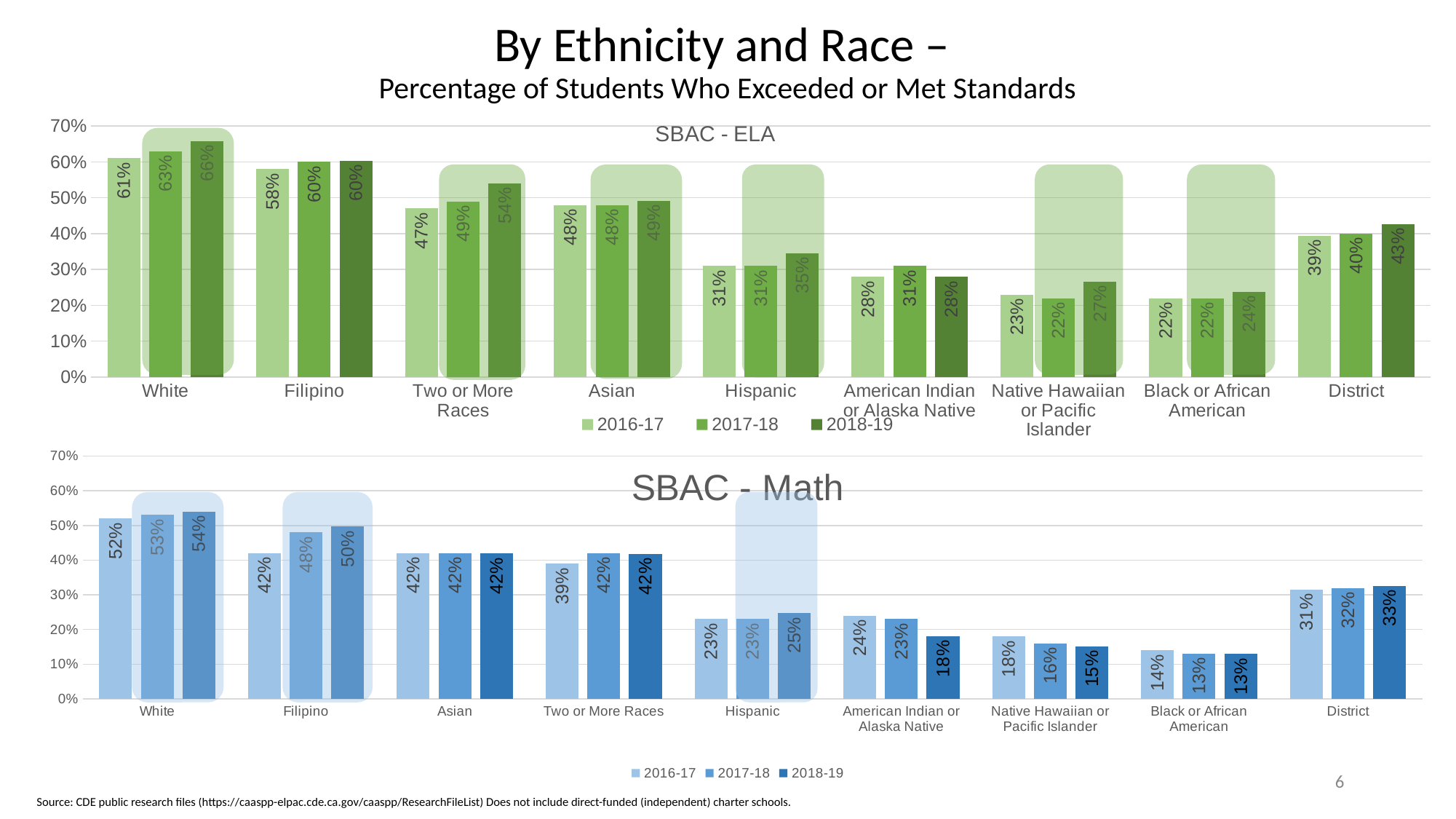
In the SBAC - Math chart, what is the difference between the 2016-17 and 2018-19 values for American Indian or Alaska Native? 6% In the SBAC - Math chart, which category has the highest value in 2018-19? White In the SBAC - ELA chart, do the values for Hispanic rise or fall from 2017-18 to 2018-19? rise In the SBAC - ELA chart, what is the District value for 2017-18? 40% In the SBAC - ELA chart, how many series does the legend list? 3 In the SBAC - ELA chart, what is the value for White in 2018-19? 66% In the SBAC - ELA chart, what is the difference between the 2018-19 and 2016-17 values for Two or More Races? 7% How many categories are shown on the x axis of the SBAC - Math chart? 9 In the SBAC - ELA chart, which category has the lowest value in 2016-17? Black or African American In the SBAC - Math chart, which is larger: the 2018-19 value for American Indian or Alaska Native or the 2018-19 value for Hispanic? Hispanic In the SBAC - Math chart, what is the value for Filipino in 2017-18? 48% What type of chart is the SBAC - Math chart? bar chart